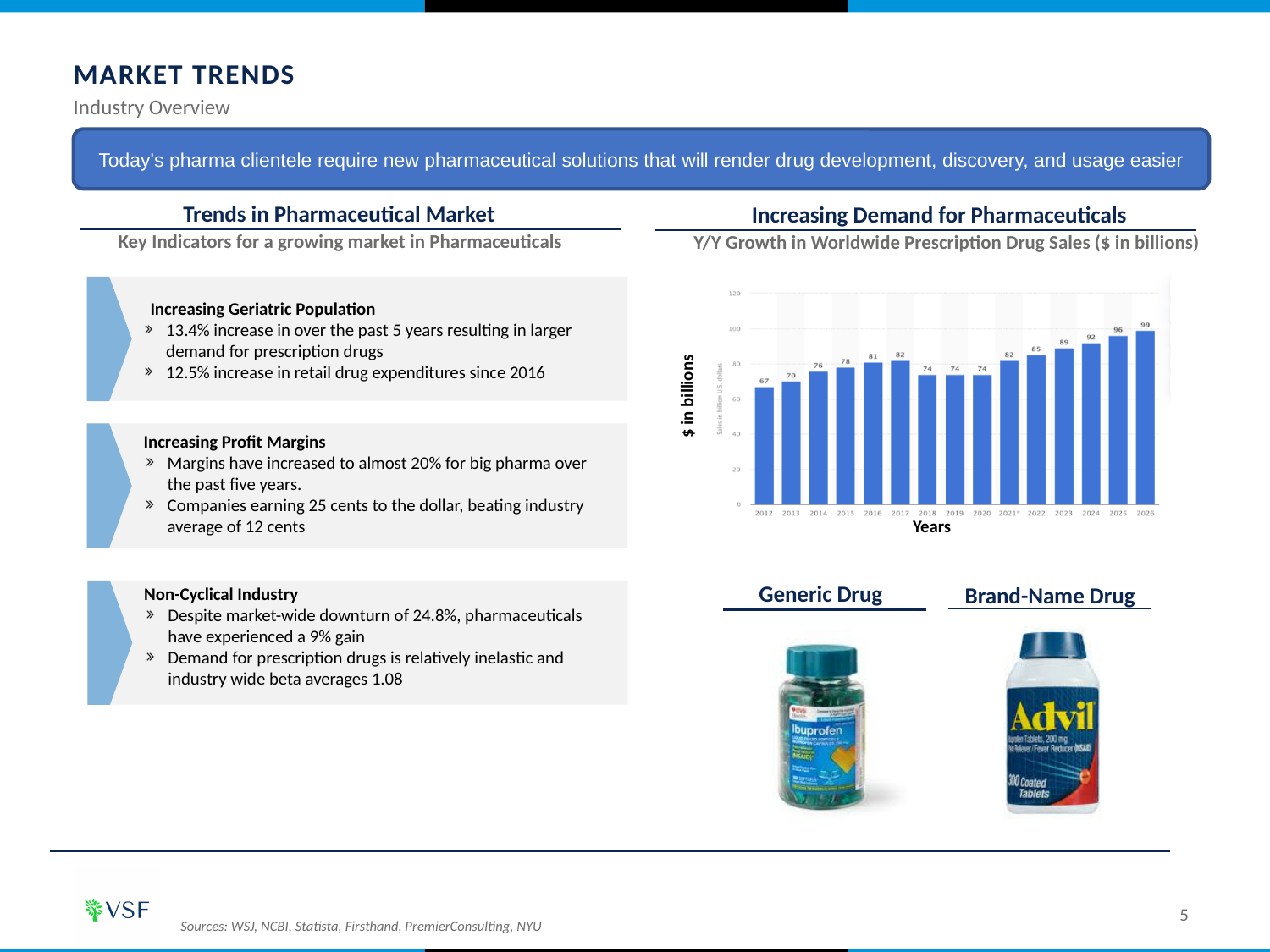
Which year has the lowest value in the prescription drug sales chart? 2012 What is the value for 2026 in the prescription drug sales chart? 99 Which year has the highest value in the prescription drug sales chart? 2026 What is the value for 2017 in the prescription drug sales chart? 82 What is the label on the vertical axis of the prescription drug sales chart? $ in billions Do the values in the prescription drug sales chart generally rise or fall from 2021 to 2026? Rise How many years are plotted in the prescription drug sales chart? 15 What type of chart is shown under "Increasing Demand for Pharmaceuticals"? Bar chart Is the value for 2025 in the prescription drug sales chart greater or less than 80? greater What is the difference between the 2026 and 2012 values in the prescription drug sales chart? 32 Which is larger in the prescription drug sales chart, the value for 2016 or the value for 2019? 2016 What is the value for 2012 in the prescription drug sales chart? 67